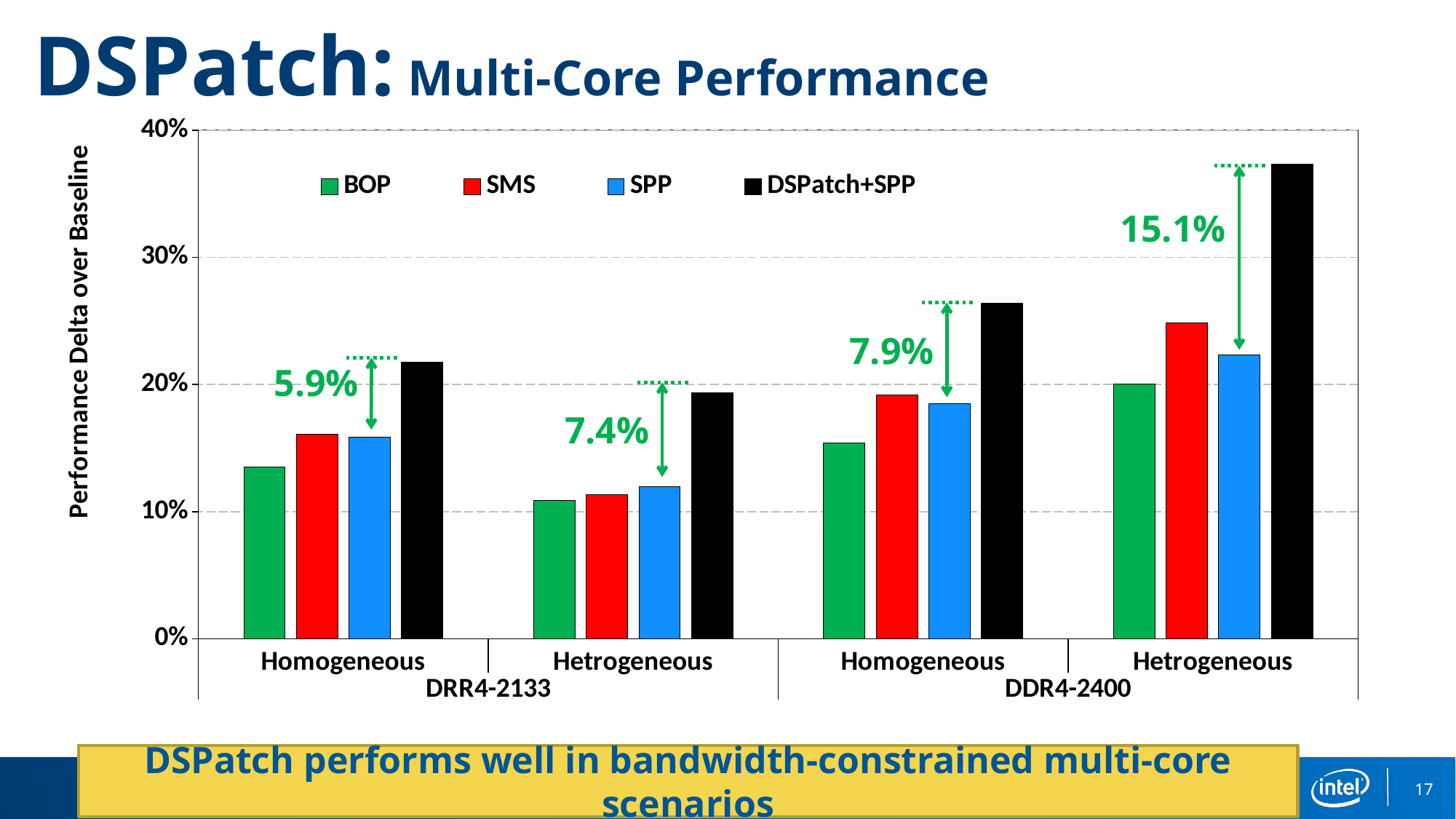
What improvement of DSPatch+SPP over SPP is annotated for the Homogeneous DRR4-2133 group? 5.9% In the Hetrogeneous DDR4-2400 group, which is larger, the SMS value or the SPP value? SMS Which category group has the largest annotated improvement of DSPatch+SPP over SPP? Hetrogeneous DDR4-2400 What improvement of DSPatch+SPP over SPP is annotated for the Hetrogeneous DDR4-2400 group? 15.1% Is the BOP value for the Homogeneous DRR4-2133 group greater or less than 20%? less Is the DSPatch+SPP value for the Hetrogeneous DDR4-2400 group greater or less than 30%? greater What improvement of DSPatch+SPP over SPP is annotated for the Hetrogeneous DRR4-2133 group? 7.4% How many series does the chart legend list? 4 What improvement of DSPatch+SPP over SPP is annotated for the Homogeneous DDR4-2400 group? 7.9% How many category groups are shown along the x axis of the chart? 4 What kind of chart is shown on the slide? bar chart What is the label of the chart's y axis? Performance Delta over Baseline